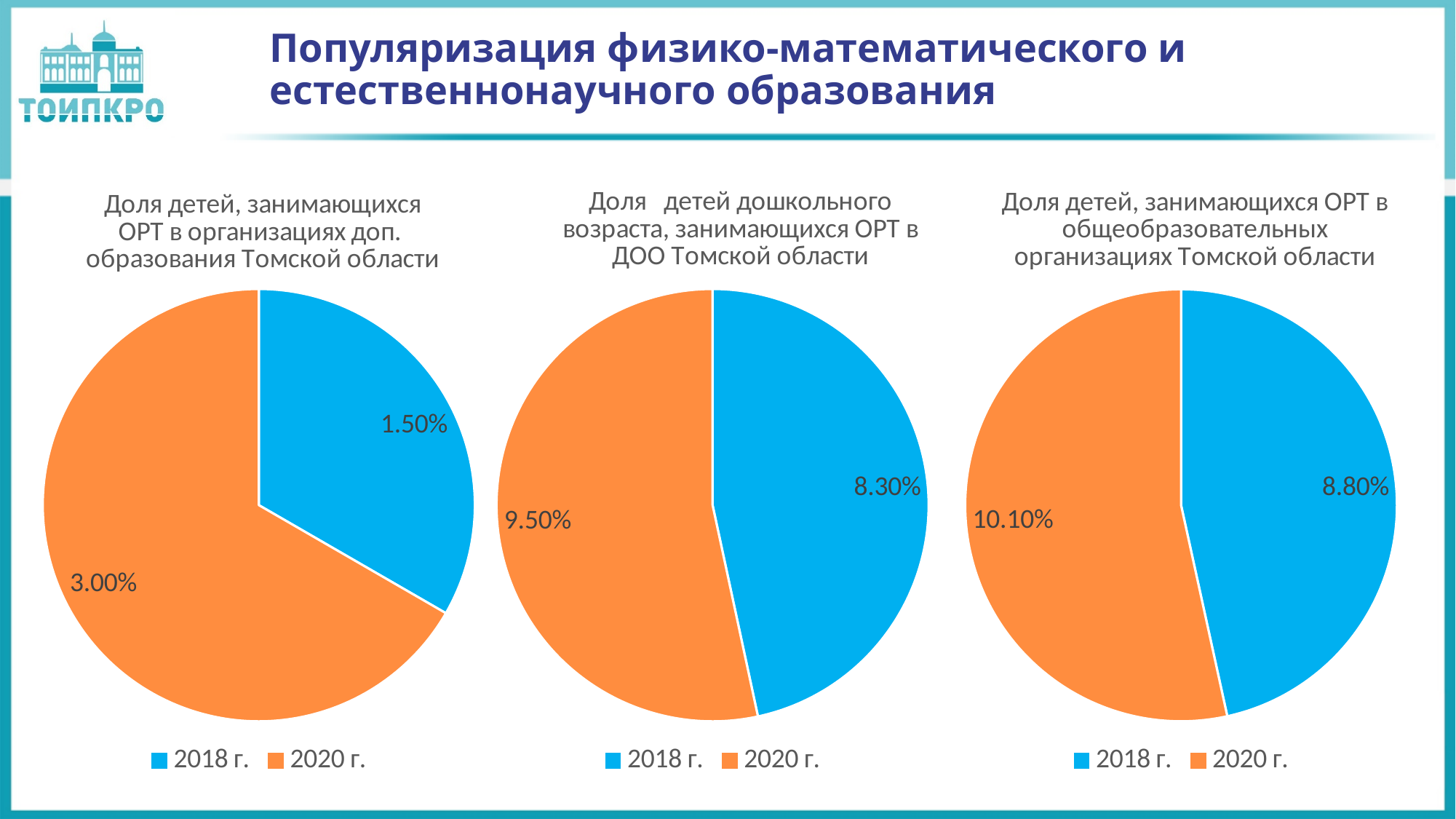
In the middle pie chart, what is the value for 2020 г.? 9.50% What type of chart is used for the three charts on the slide? Pie chart In the right pie chart, what is the value for 2018 г.? 8.80% In the left pie chart, what is the difference between the 2020 г. and 2018 г. values? 1.50% How many series does the legend of the left chart list? 2 In the right pie chart, what is the difference between the 2020 г. and 2018 г. values? 1.30% In the middle pie chart, which year has the larger value, 2018 г. or 2020 г.? 2020 г. In the right pie chart (Доля детей, занимающихся ОРТ в общеобразовательных организациях Томской области), what is the value for 2020 г.? 10.10% In the left pie chart, what is the value for 2020 г.? 3.00% In the middle pie chart (Доля детей дошкольного возраста, занимающихся ОРТ в ДОО Томской области), what is the value for 2018 г.? 8.30% In the left pie chart (Доля детей, занимающихся ОРТ в организациях доп. образования Томской области), what is the value for 2018 г.? 1.50% In the right pie chart, which colour represents 2020 г.? Orange